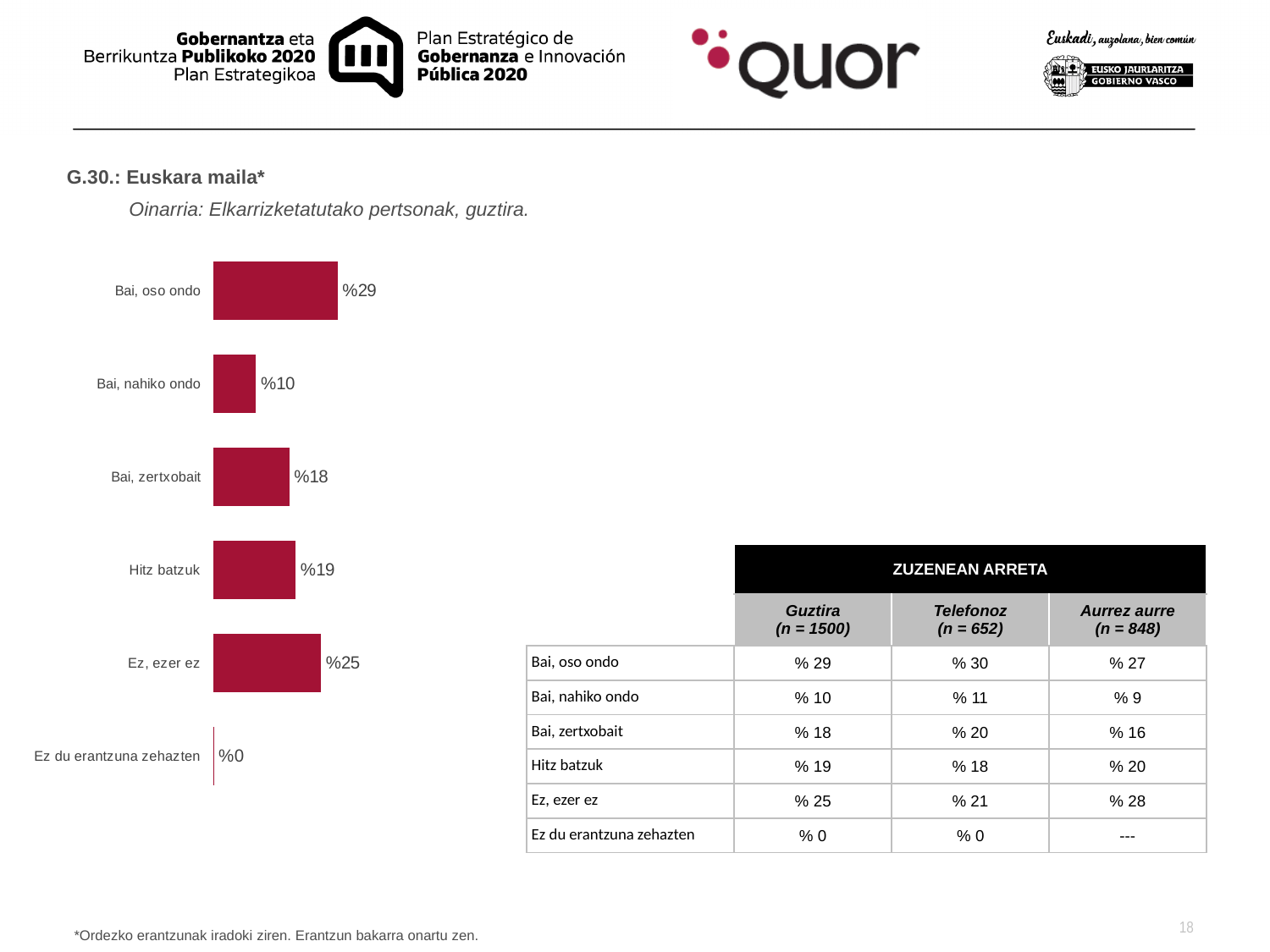
What is the difference between the values for "Hitz batzuk" and "Bai, zertxobait" in the bar chart? %1 Which is larger in the bar chart, "Bai, zertxobait" or "Bai, nahiko ondo"? Bai, zertxobait What is the difference between the values for "Bai, oso ondo" and "Ez, ezer ez" in the bar chart? %4 What colour are the bars in the chart? Dark red What kind of chart is shown on the slide? Bar chart What is the value for "Bai, oso ondo" in the bar chart? %29 What is the value for "Ez, ezer ez" in the bar chart? %25 Which category has the lowest value in the bar chart? Ez du erantzuna zehazten What is the title of the chart on the slide? G.30.: Euskara maila* Which category has the highest value in the bar chart? Bai, oso ondo What is the value for "Bai, nahiko ondo" in the bar chart? %10 How many categories are shown in the bar chart? 6